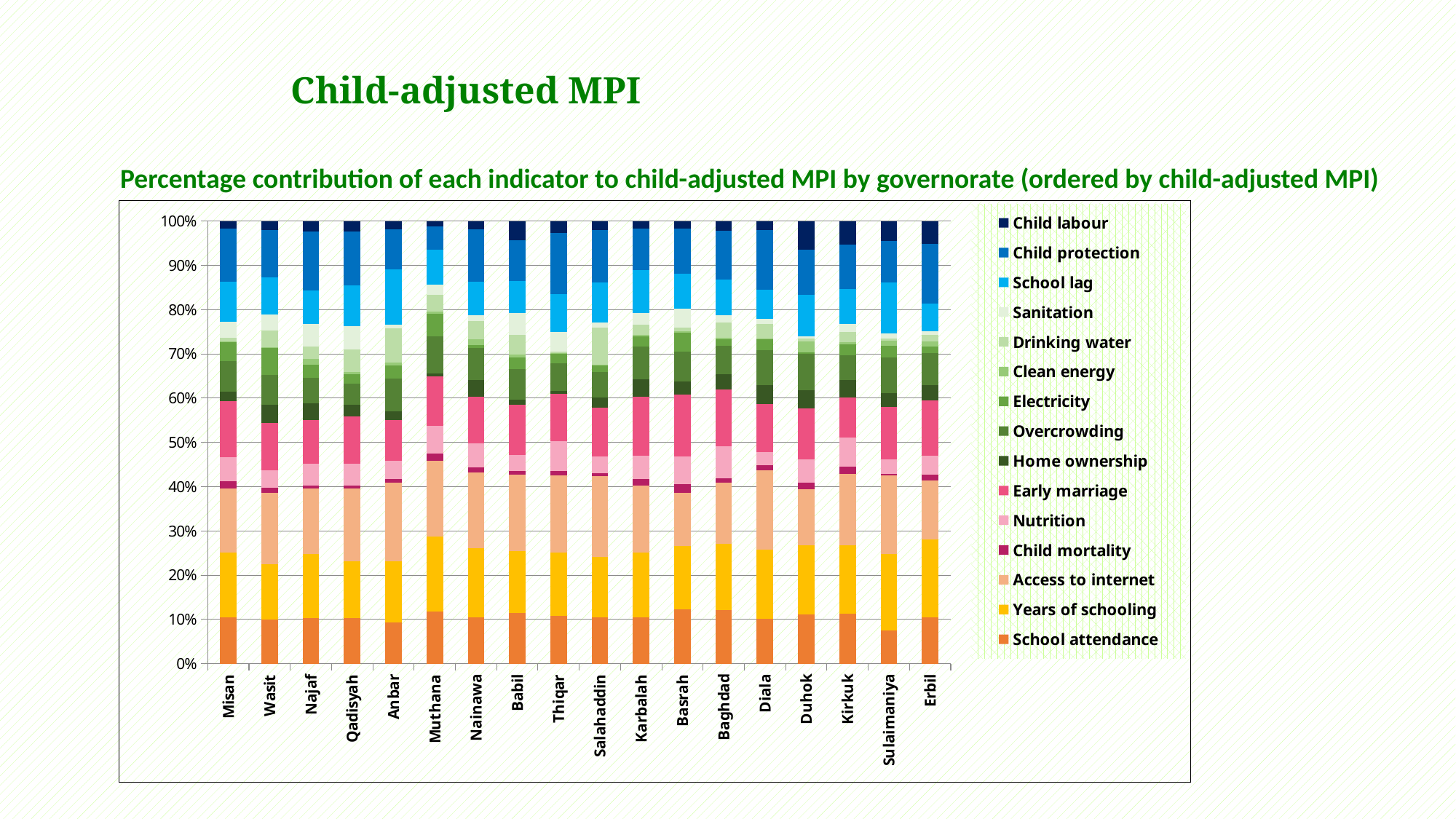
What kind of chart is shown on the slide? Stacked bar chart How many indicators (series) does the chart legend list? 15 What is the title of the chart? Percentage contribution of each indicator to child-adjusted MPI by governorate (ordered by child-adjusted MPI) Which indicator is listed last in the chart legend? School attendance Is the School attendance contribution for Basrah greater or less than 10%? greater Which governorate is the last (rightmost) category on the x axis? Erbil Which governorate is the first (leftmost) category on the x axis? Misan What is the total height of each stacked bar in the chart? 100% How many governorates are shown along the x axis of the chart? 18 Is the School attendance contribution for Sulaimaniya greater or less than 10%? less Which governorate has the lowest School attendance contribution? Sulaimaniya Which has the larger School attendance contribution, Basrah or Sulaimaniya? Basrah